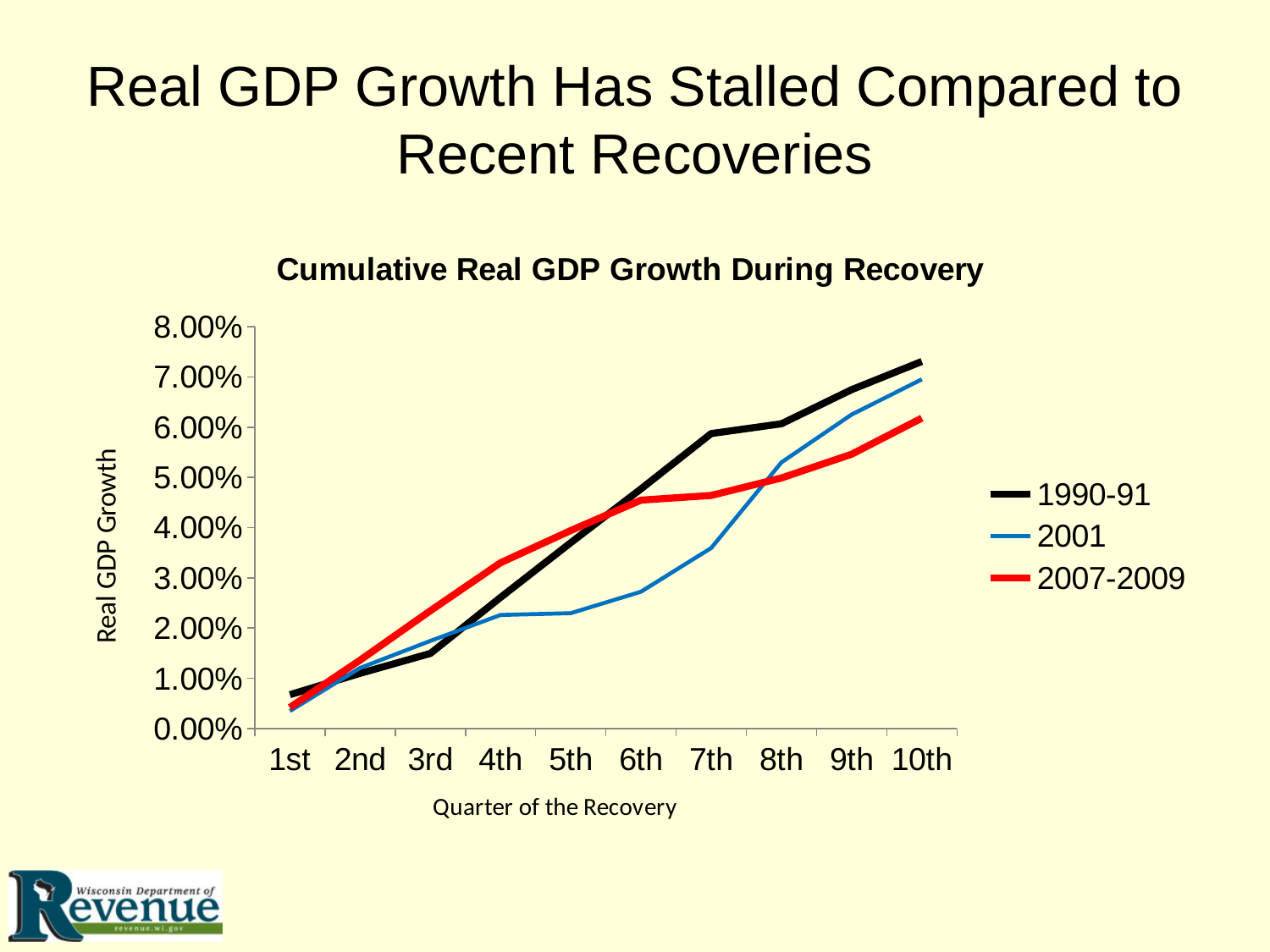
Is the value for 2007-2009 at the 10th quarter greater or less than 7.00%? less How many series does the legend list? 3 At the 7th quarter, which is larger: the value for 1990-91 or the value for 2007-2009? 1990-91 What kind of chart is shown on the slide? line chart What is the title of the chart? Cumulative Real GDP Growth During Recovery At the 5th quarter, which is larger: the value for 2007-2009 or the value for 2001? 2007-2009 Is the value for 1990-91 at the 10th quarter greater or less than 7.00%? greater How many quarters are plotted along the x axis? 10 Which recovery has the lowest cumulative real GDP growth at the 10th quarter? 2007-2009 Is the value for 2001 at the 5th quarter greater or less than 3.00%? less Does the 1990-91 line rise or fall from the 1st quarter to the 10th quarter? rise Which recovery has the highest cumulative real GDP growth at the 10th quarter? 1990-91